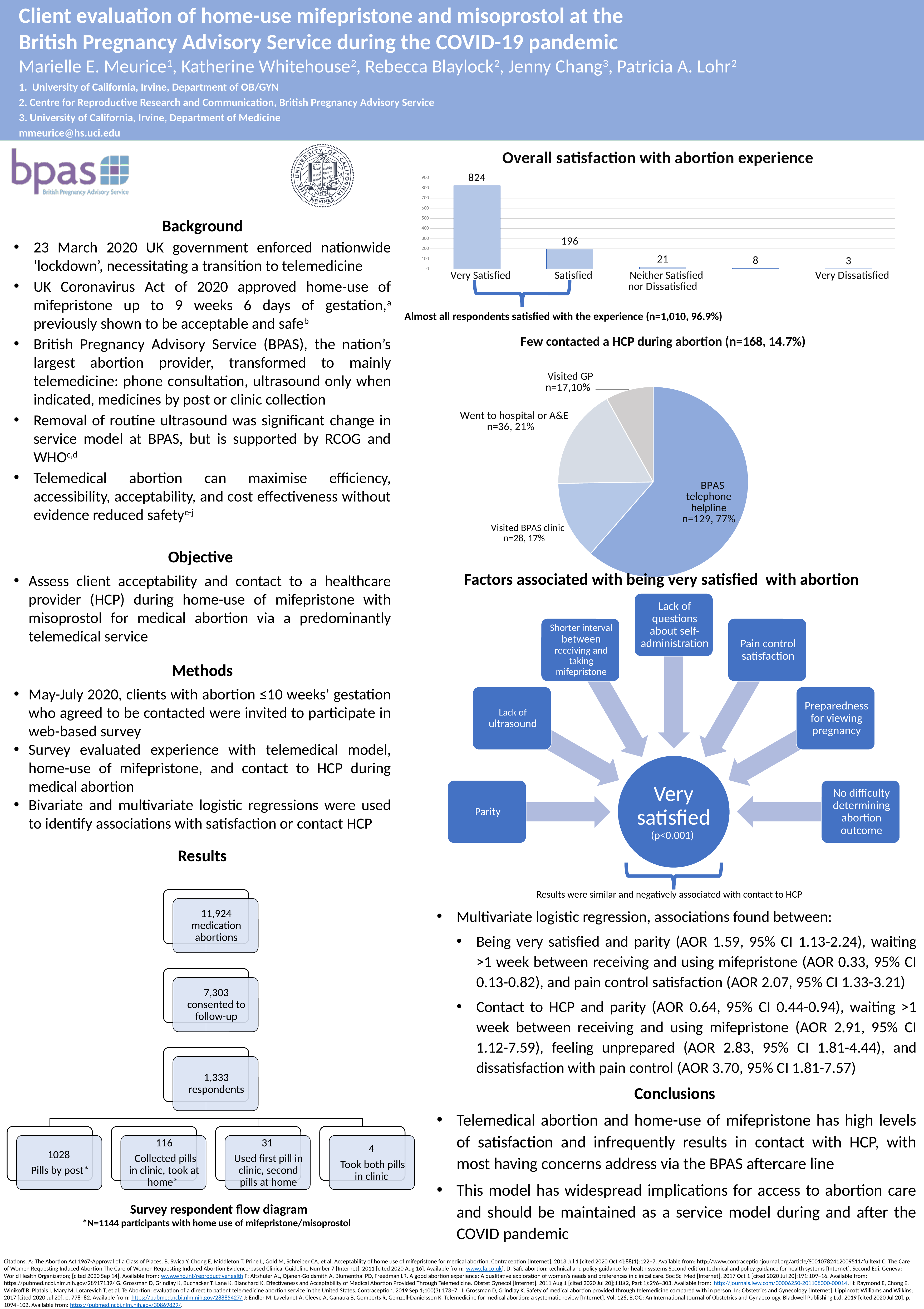
In the 'Overall satisfaction with abortion experience' chart, what is the difference between the Very Satisfied and Satisfied values? 628 In the 'Overall satisfaction with abortion experience' chart, is the value for Satisfied greater or less than 300? less In the 'Overall satisfaction with abortion experience' chart, do the values rise or fall from left to right along the x axis? fall In the 'Overall satisfaction with abortion experience' chart, what is the value for Neither Satisfied nor Dissatisfied? 21 In the 'Few contacted a HCP during abortion' pie chart, what is the n value for Went to hospital or A&E? n=36 In the 'Overall satisfaction with abortion experience' chart, what is the value for Satisfied? 196 What kind of chart is 'Overall satisfaction with abortion experience'? bar chart In the 'Overall satisfaction with abortion experience' chart, what is the value for Very Satisfied? 824 In the 'Few contacted a HCP during abortion' pie chart, which slice is the smallest? Visited GP In the 'Few contacted a HCP during abortion' pie chart, what share is the BPAS telephone helpline slice? 77% In the 'Overall satisfaction with abortion experience' chart, which category has the highest value? Very Satisfied In the 'Overall satisfaction with abortion experience' chart, what is the value for Very Dissatisfied? 3